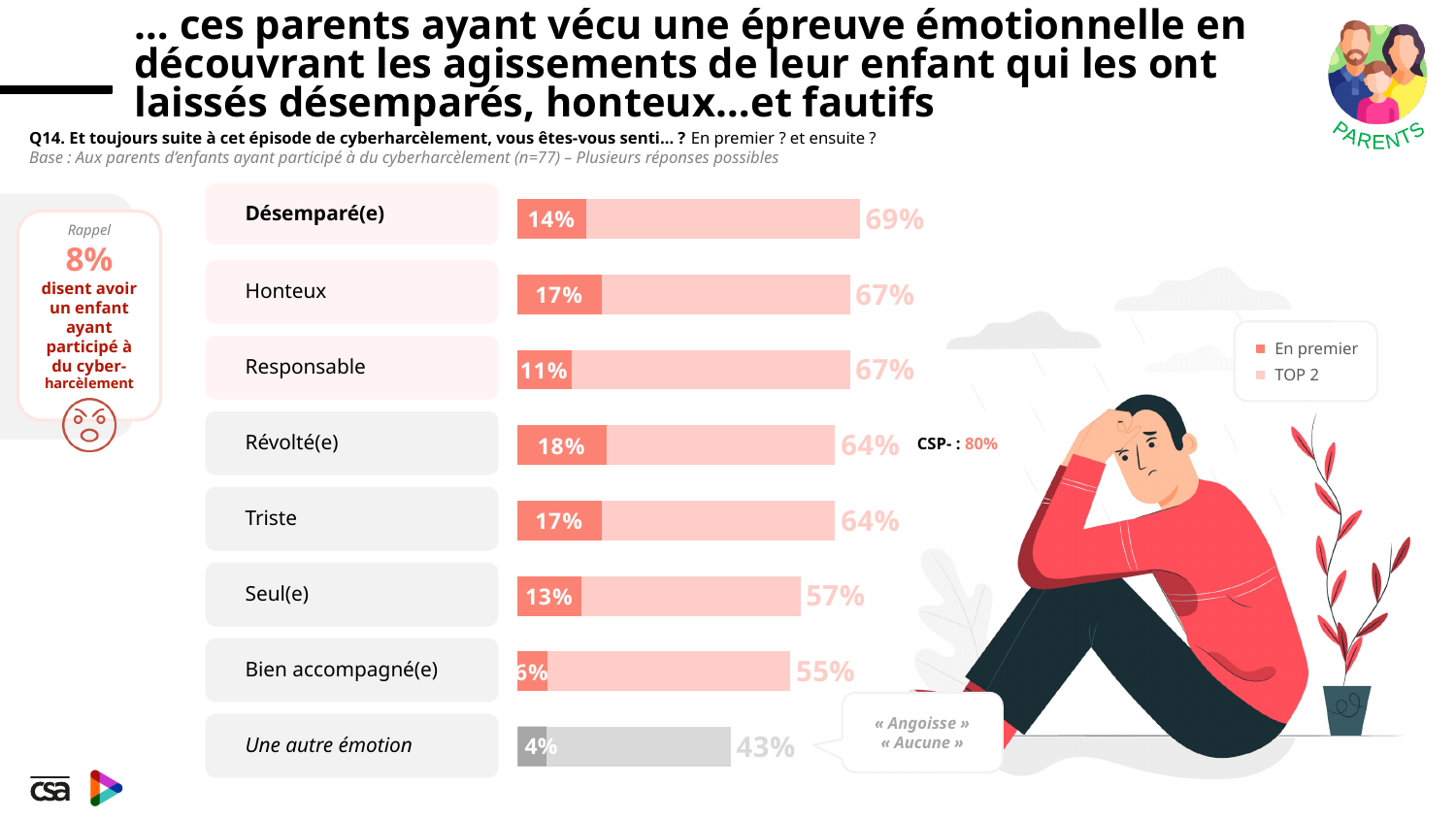
What is the En premier value for Bien accompagné(e)? 6% How many series does the legend list? 2 What is the TOP 2 value for Seul(e)? 57% Which category has the highest En premier value? Révolté(e) What kind of chart is shown on the slide? Bar chart What is the En premier value for Révolté(e)? 18% How many categories are shown in the chart? 8 Which category has the highest TOP 2 value? Désemparé(e) Which is larger, the En premier value for Honteux or for Responsable? Honteux What is the TOP 2 value for Désemparé(e)? 69% What is the difference between the TOP 2 values for Désemparé(e) and Une autre émotion? 26 percentage points Which category has the lowest En premier value? Une autre émotion